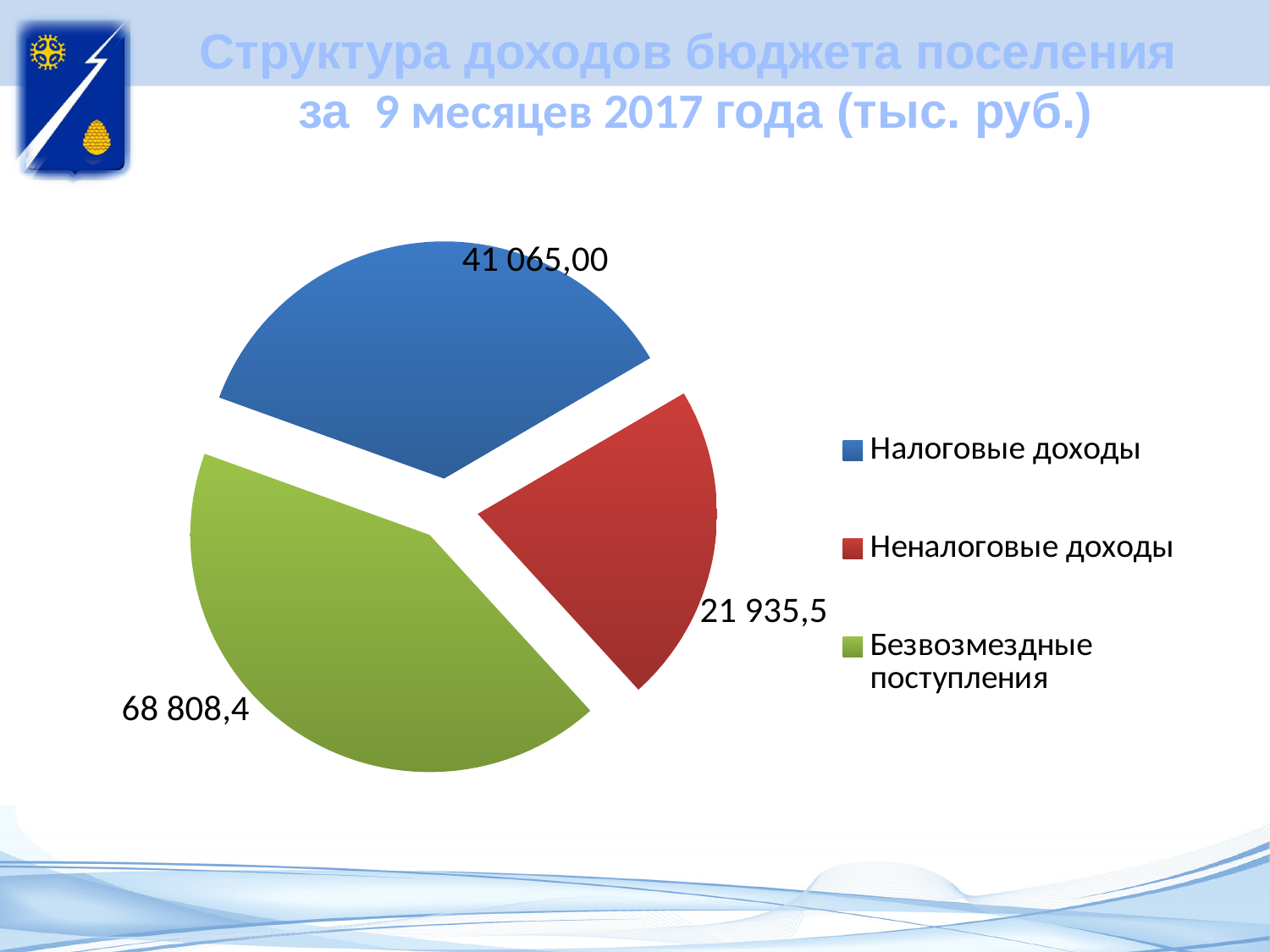
What kind of chart is shown on the slide? pie chart What is the value for Неналоговые доходы? 21 935,5 Which is larger, Налоговые доходы or Неналоговые доходы? Налоговые доходы What is the difference between Безвозмездные поступления and Налоговые доходы? 27 743,4 Which category has the largest slice of the pie? Безвозмездные поступления What is the value for Безвозмездные поступления? 68 808,4 How many categories does the pie chart have? 3 How many entries does the legend list? 3 What is the value for Налоговые доходы? 41 065,00 What is the difference between Налоговые доходы and Неналоговые доходы? 19 129,5 Which category has the smallest slice of the pie? Неналоговые доходы What colour is the slice for Безвозмездные поступления? green